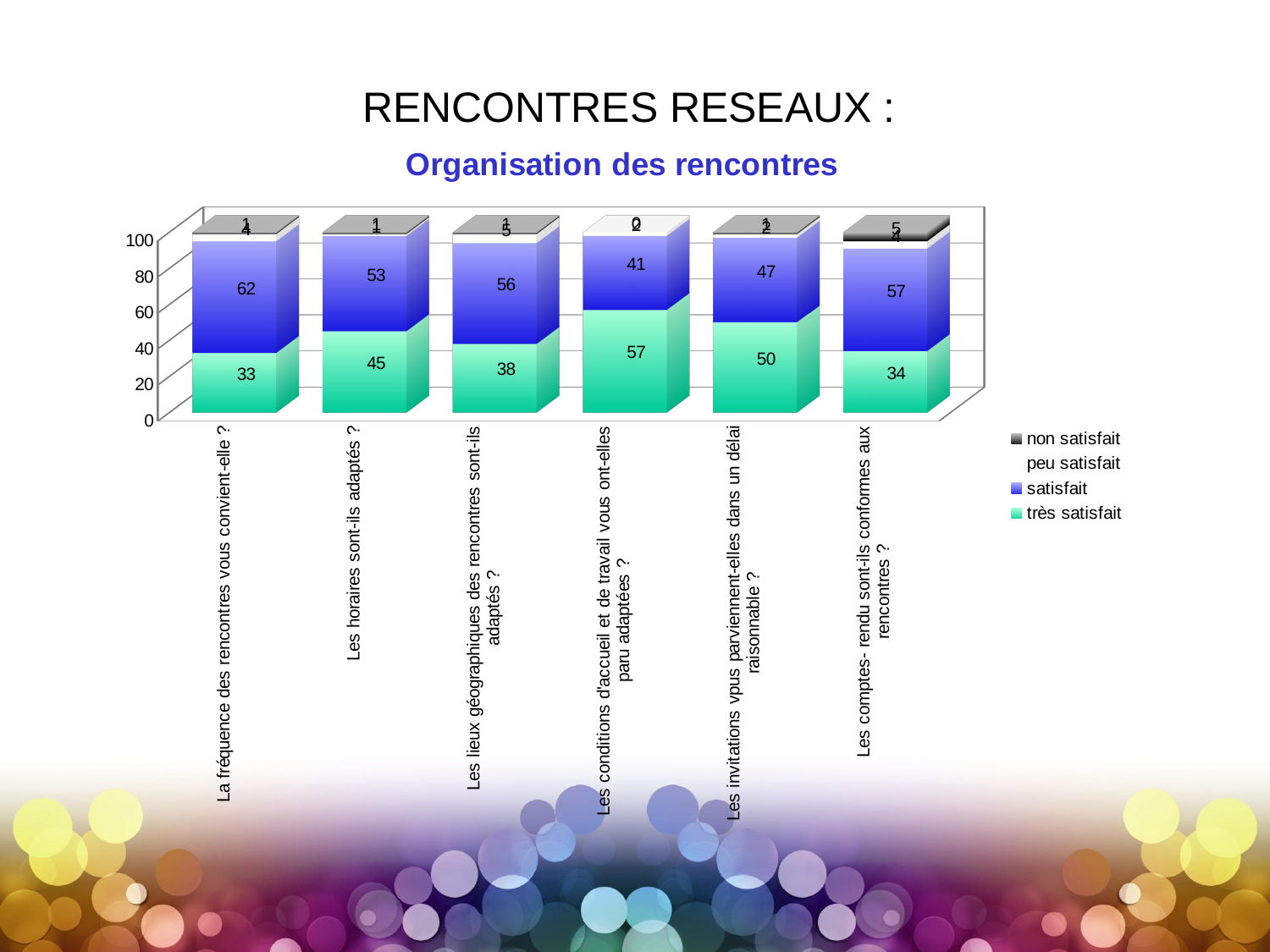
What is the difference between the 'satisfait' and 'très satisfait' values for 'La fréquence des rencontres vous convient-elle ?'? 29 What is the 'satisfait' value for 'Les comptes- rendu sont-ils conformes aux rencontres ?'? 57 What is the 'satisfait' value for 'Les horaires sont-ils adaptés ?'? 53 Which category has the highest 'satisfait' value? La fréquence des rencontres vous convient-elle ? Which category has the highest 'très satisfait' value? Les conditions d'accueil et de travail vous ont-elles paru adaptées ? How many categories (questions) are plotted on the x axis? 6 What type of chart is shown on the slide? stacked bar chart Which category has the lowest 'très satisfait' value? La fréquence des rencontres vous convient-elle ? What is the 'très satisfait' value for 'La fréquence des rencontres vous convient-elle ?'? 33 How many series does the legend list? 4 What is the 'très satisfait' value for 'Les conditions d'accueil et de travail vous ont-elles paru adaptées ?'? 57 Is the 'très satisfait' value larger for 'Les horaires sont-ils adaptés ?' or for 'Les lieux géographiques des rencontres sont-ils adaptés ?'? Les horaires sont-ils adaptés ?